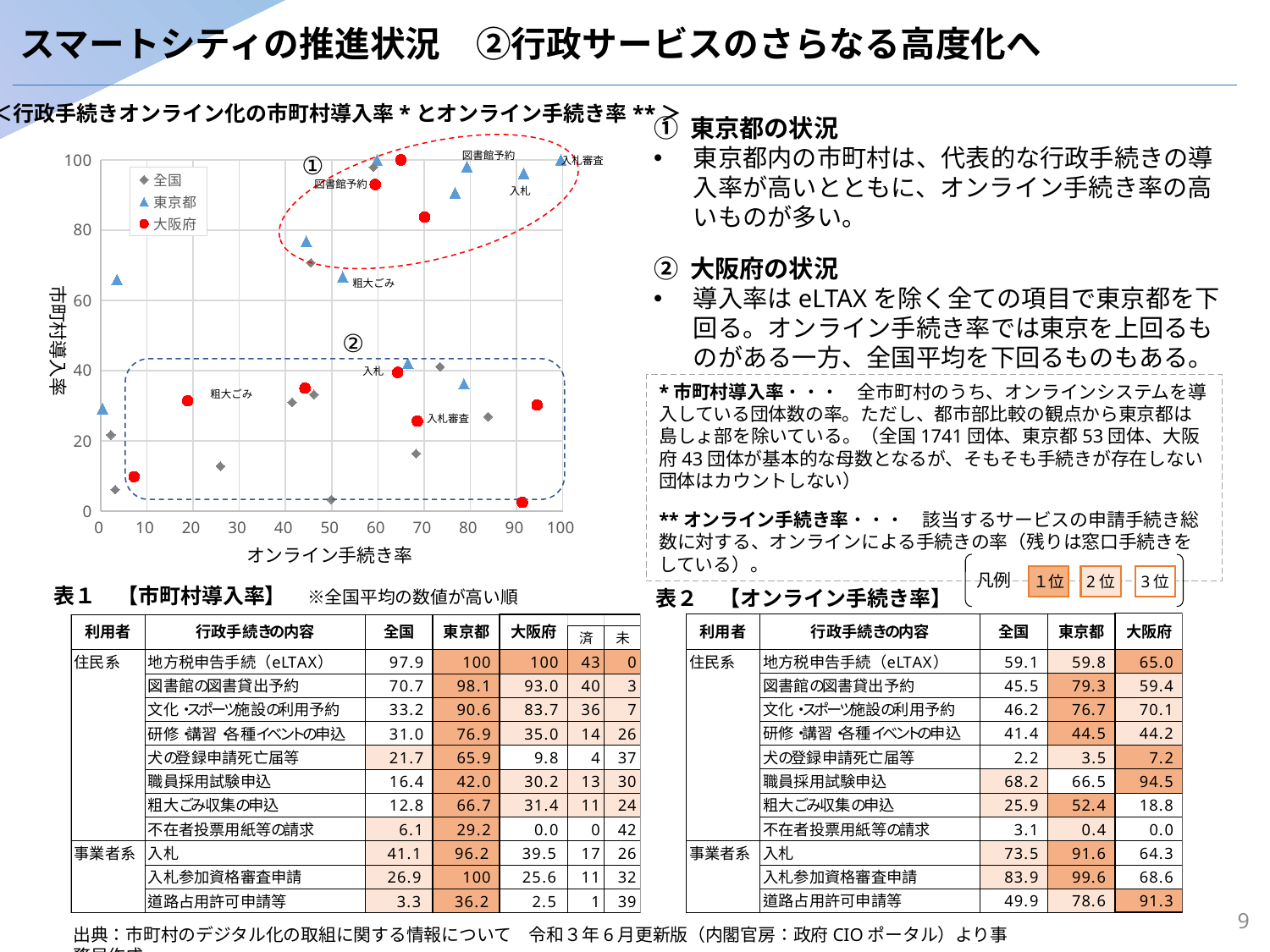
What kind of chart is shown on the left of the slide? scatter chart In the scatter chart, is the 市町村導入率 value for the 大阪府 point labeled 図書館予約 greater or less than 80? greater In the scatter chart, is the オンライン手続き率 value for the 東京都 point labeled 入札 greater or less than 80? greater What is the maximum value shown on the vertical axis of the scatter chart? 100 In the scatter chart, is the 市町村導入率 value for the 東京都 point labeled 粗大ごみ greater or less than 60? greater In the scatter chart, which has the higher 市町村導入率: the 東京都 point labeled 入札審査 or the 大阪府 point labeled 入札審査? 東京都 How many series does the legend of the scatter chart list? 3 What is the title of the horizontal axis of the scatter chart? オンライン手続き率 What are the three series named in the legend of the scatter chart? 全国, 東京都, 大阪府